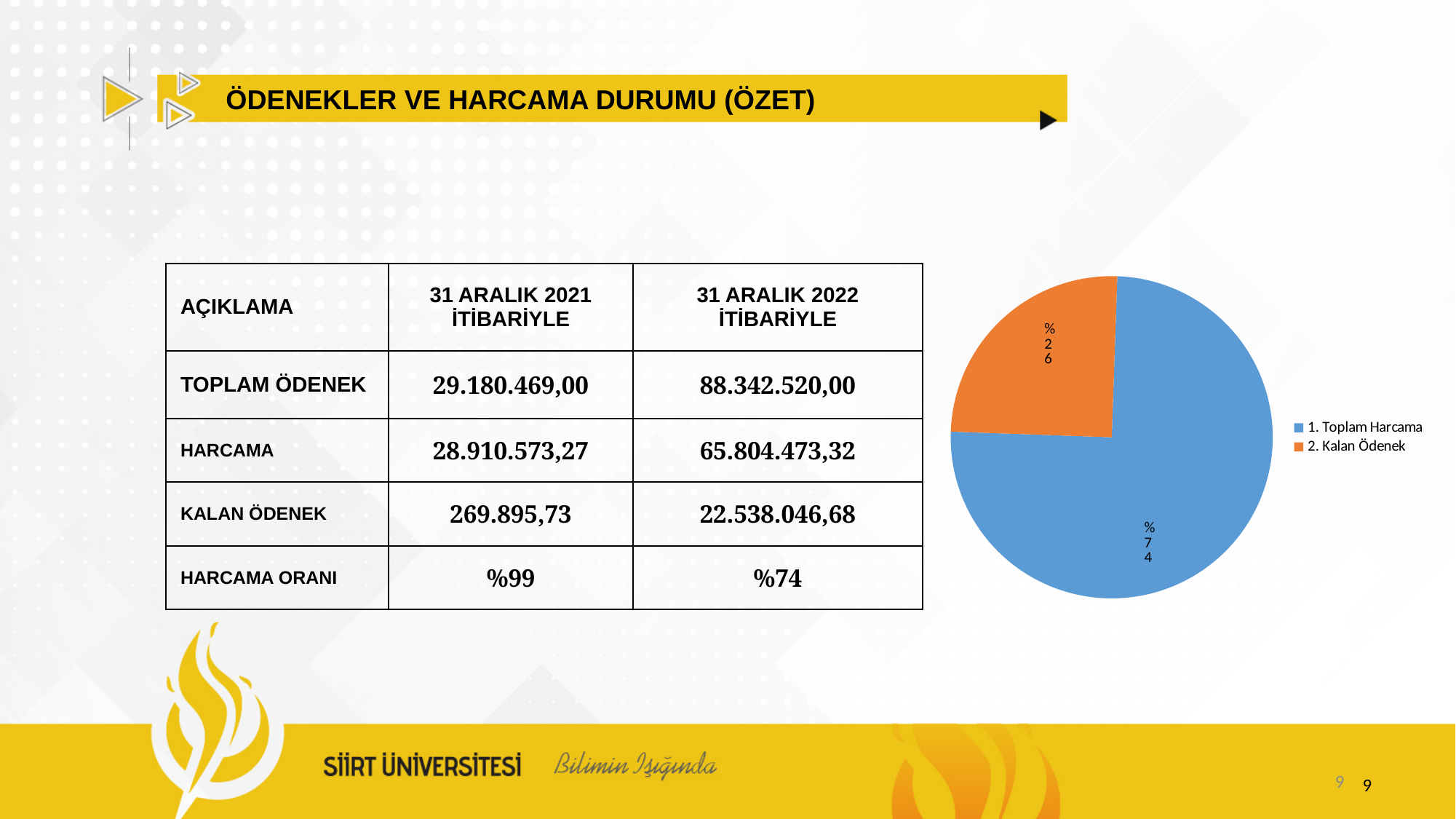
How many slices does the pie chart have? 2 Which slice of the pie chart is the largest? 1. Toplam Harcama How many entries does the pie chart's legend list? 2 What share of the pie chart is labelled for 1. Toplam Harcama? %74 Which slice of the pie chart is the smallest? 2. Kalan Ödenek In the pie chart, which is larger: 1. Toplam Harcama or 2. Kalan Ödenek? 1. Toplam Harcama What share of the pie chart is labelled for 2. Kalan Ödenek? %26 In the pie chart, what is the difference in percentage points between the 1. Toplam Harcama slice and the 2. Kalan Ödenek slice? 48 What colour is the 1. Toplam Harcama slice in the pie chart? blue What colour is the 2. Kalan Ödenek slice in the pie chart? orange What kind of chart is shown on the slide? pie chart